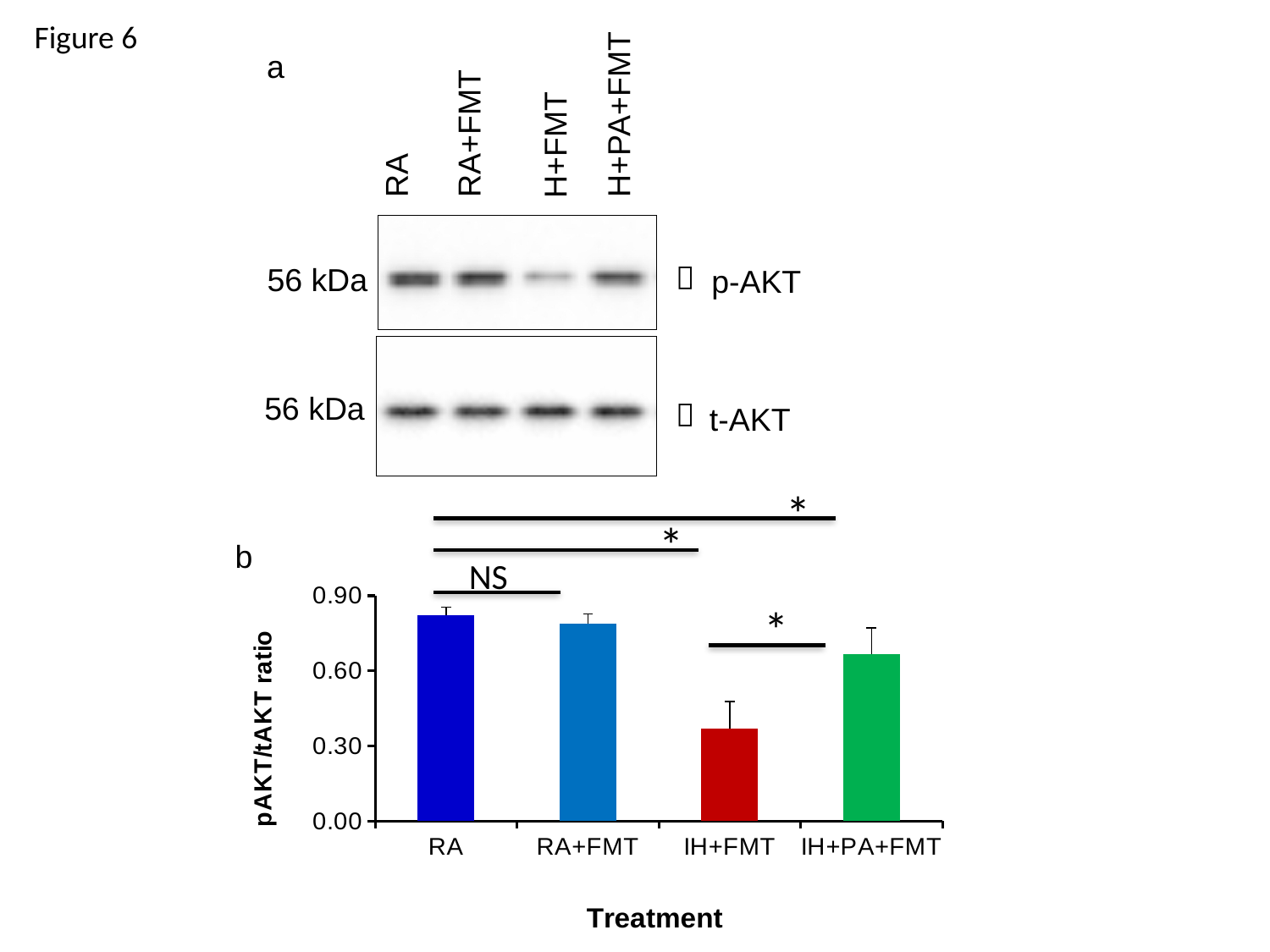
What kind of chart is shown in panel b? bar chart What colour is the IH+FMT bar in the bar chart in panel b? red In the bar chart in panel b, is the value for RA greater or less than 0.60? greater What is the y-axis title of the bar chart in panel b? pAKT/tAKT ratio In the bar chart in panel b, is the value for IH+PA+FMT greater or less than 0.60? greater In the bar chart in panel b, is the value for IH+FMT greater or less than 0.60? less How many treatment categories are plotted in the bar chart in panel b? 4 In the bar chart in panel b, which has the larger pAKT/tAKT ratio, IH+FMT or IH+PA+FMT? IH+PA+FMT In the bar chart in panel b, which has the larger pAKT/tAKT ratio, RA or IH+FMT? RA In the bar chart in panel b, which treatment has the lowest pAKT/tAKT ratio? IH+FMT